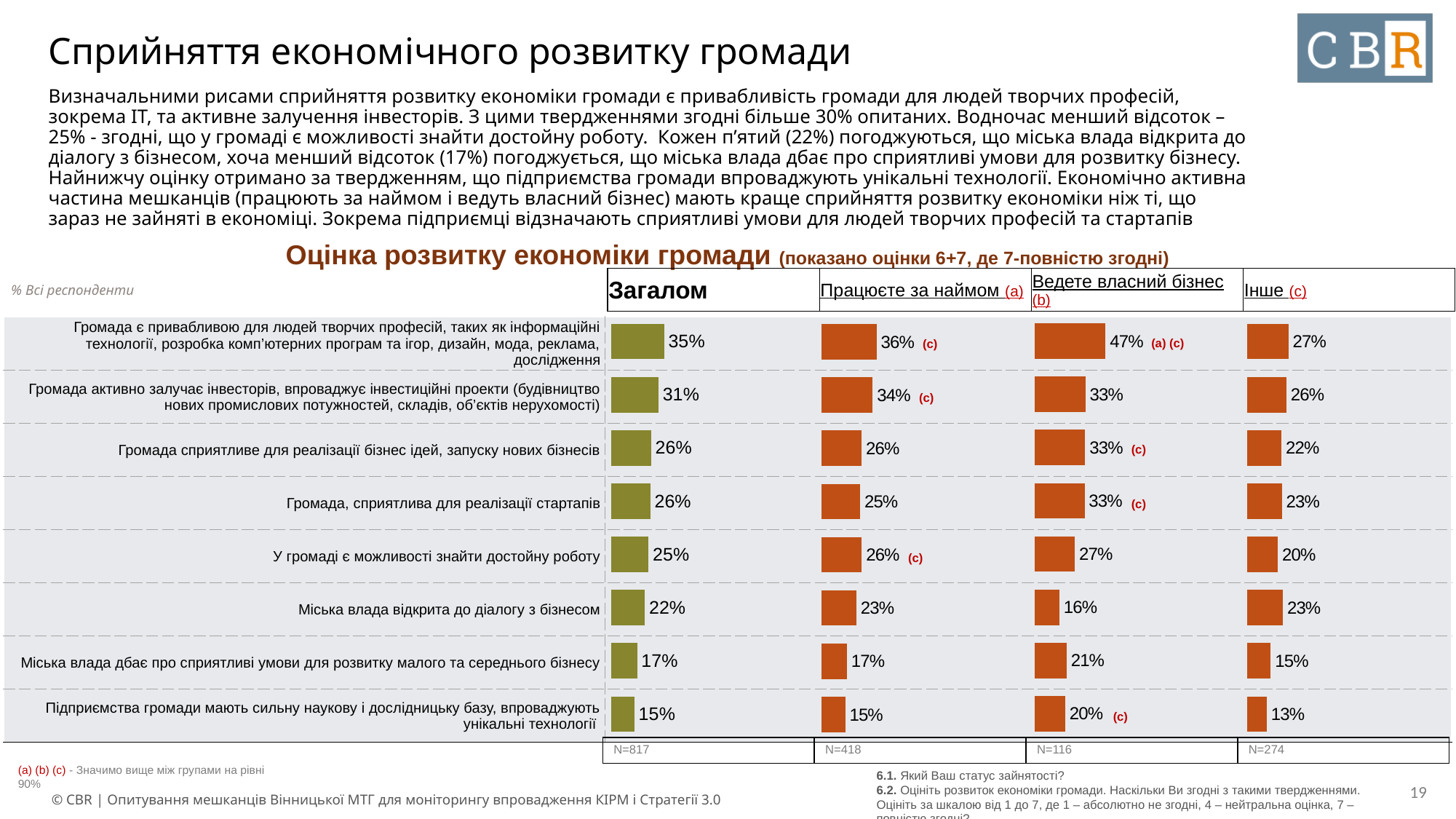
For 'Міська влада відкрита до діалогу з бізнесом', which is larger: the 'Працюєте за наймом (a)' value or the 'Ведете власний бізнес (b)' value? Працюєте за наймом (a) Which column has the highest value for 'Громада є привабливою для людей творчих професій...'? Ведете власний бізнес (b) In the 'Загалом' column, what is the value for 'Громада є привабливою для людей творчих професій...'? 35% In the 'Ведете власний бізнес (b)' column, which statement has the lowest value? Міська влада відкрита до діалогу з бізнесом In the 'Працюєте за наймом (a)' column, what is the value for 'У громаді є можливості знайти достойну роботу'? 26% In the 'Інше (c)' column, what is the value for 'Міська влада відкрита до діалогу з бізнесом'? 23% What type of chart is used to show the values? Bar chart In the 'Загалом' column, which statement has the lowest value? Підприємства громади мають сильну наукову і дослідницьку базу, впроваджують унікальні технології What is the difference between the 'Ведете власний бізнес (b)' and 'Інше (c)' values for 'Громада є привабливою для людей творчих професій...'? 20% How many statements are listed in the chart? 8 In the 'Ведете власний бізнес (b)' column, what is the value for 'Громада є привабливою для людей творчих професій...'? 47% What is the sample size (N) shown for the 'Ведете власний бізнес (b)' column? N=116